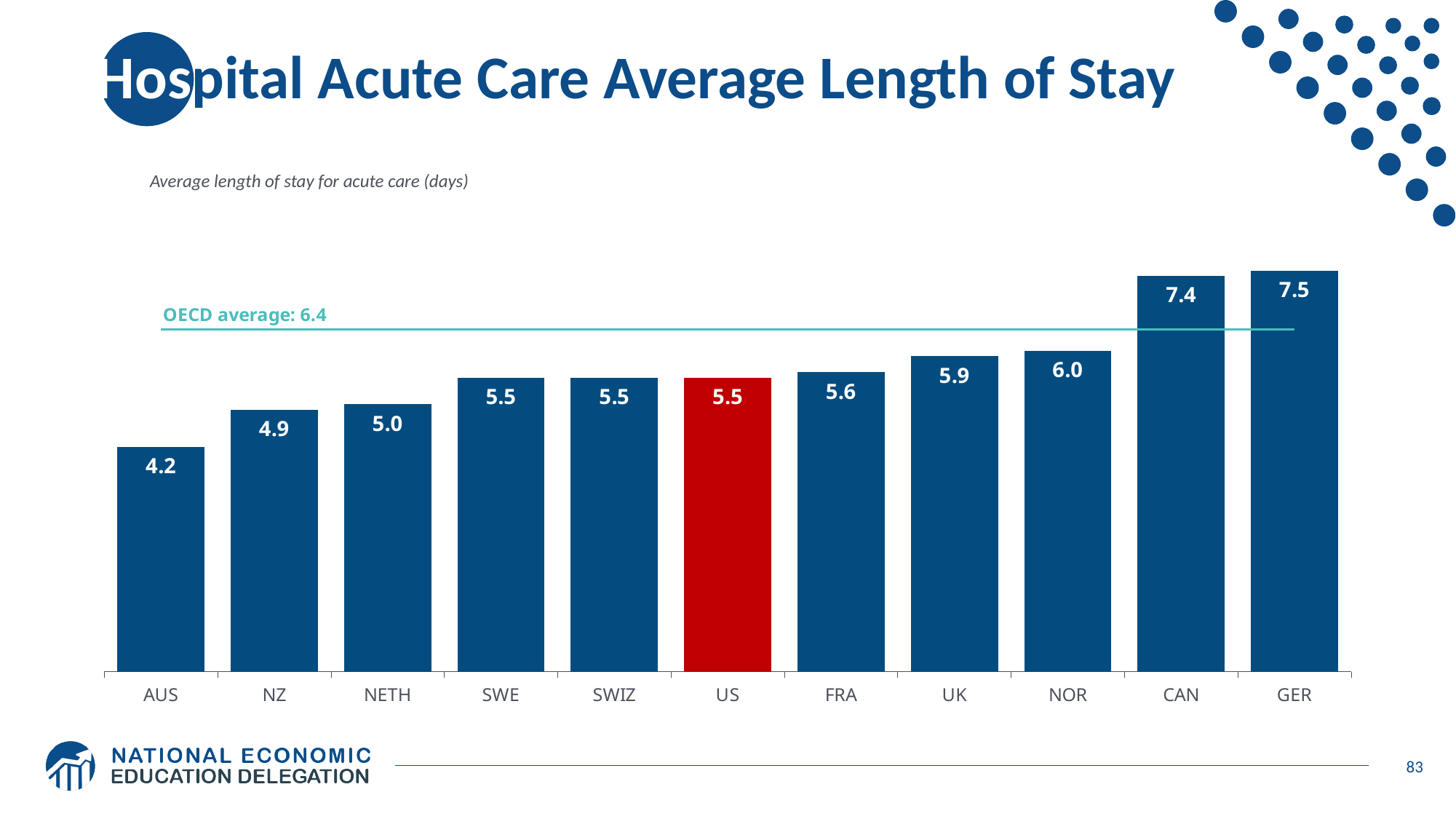
Which country has the highest average length of stay for acute care? GER What is the difference in average length of stay between CAN and the US? 1.9 What kind of chart is shown on the slide? Bar chart Which has a longer average length of stay, UK or NETH? UK What OECD average value is marked by the horizontal line on the chart? 6.4 What is the average length of stay for acute care in AUS? 4.2 Which country has the lowest average length of stay for acute care? AUS Do the values generally rise or fall from left to right across the countries? Rise What is the average length of stay for acute care in the US? 5.5 What is the difference in average length of stay between GER and AUS? 3.3 What is the average length of stay for acute care in NOR? 6.0 How many countries are shown in the chart? 11